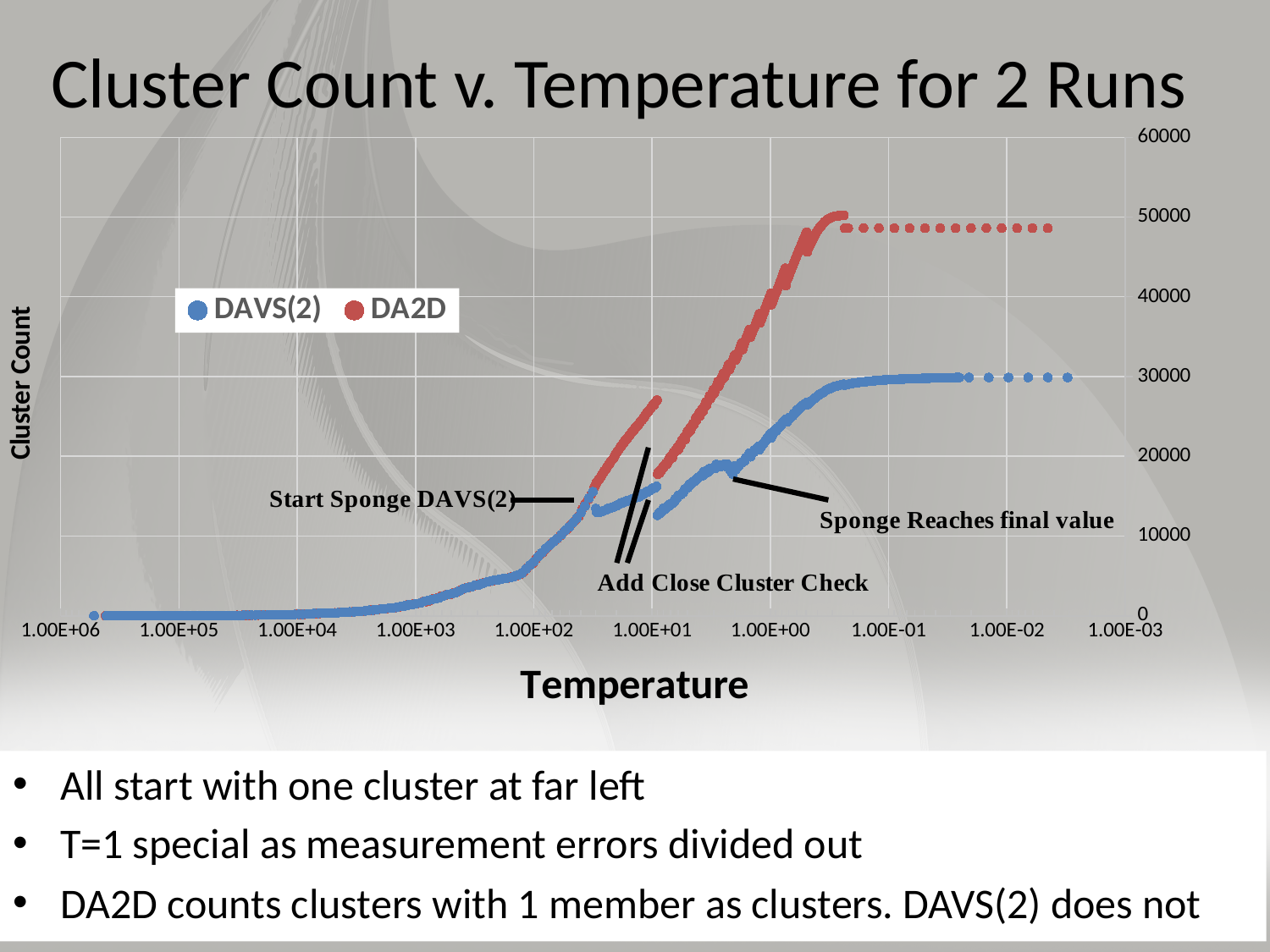
What kind of chart is shown on the slide? scatter chart What is the title of the chart? Cluster Count v. Temperature for 2 Runs What are the two series named in the legend? DAVS(2) and DA2D Overall, do the cluster counts rise or fall moving from left to right along the temperature axis? rise Is the cluster count for DAVS(2) at a temperature of 1.00E+05 greater or less than 10000? less Which series has the lower final cluster count? DAVS(2) How many series does the legend list? 2 Is the final plateau value of the DAVS(2) series greater or less than 20000? greater Which series has the higher maximum cluster count? DA2D Is the final plateau value of the DA2D series greater or less than 40000? greater Which series reaches the higher cluster count at the right end of the chart? DA2D